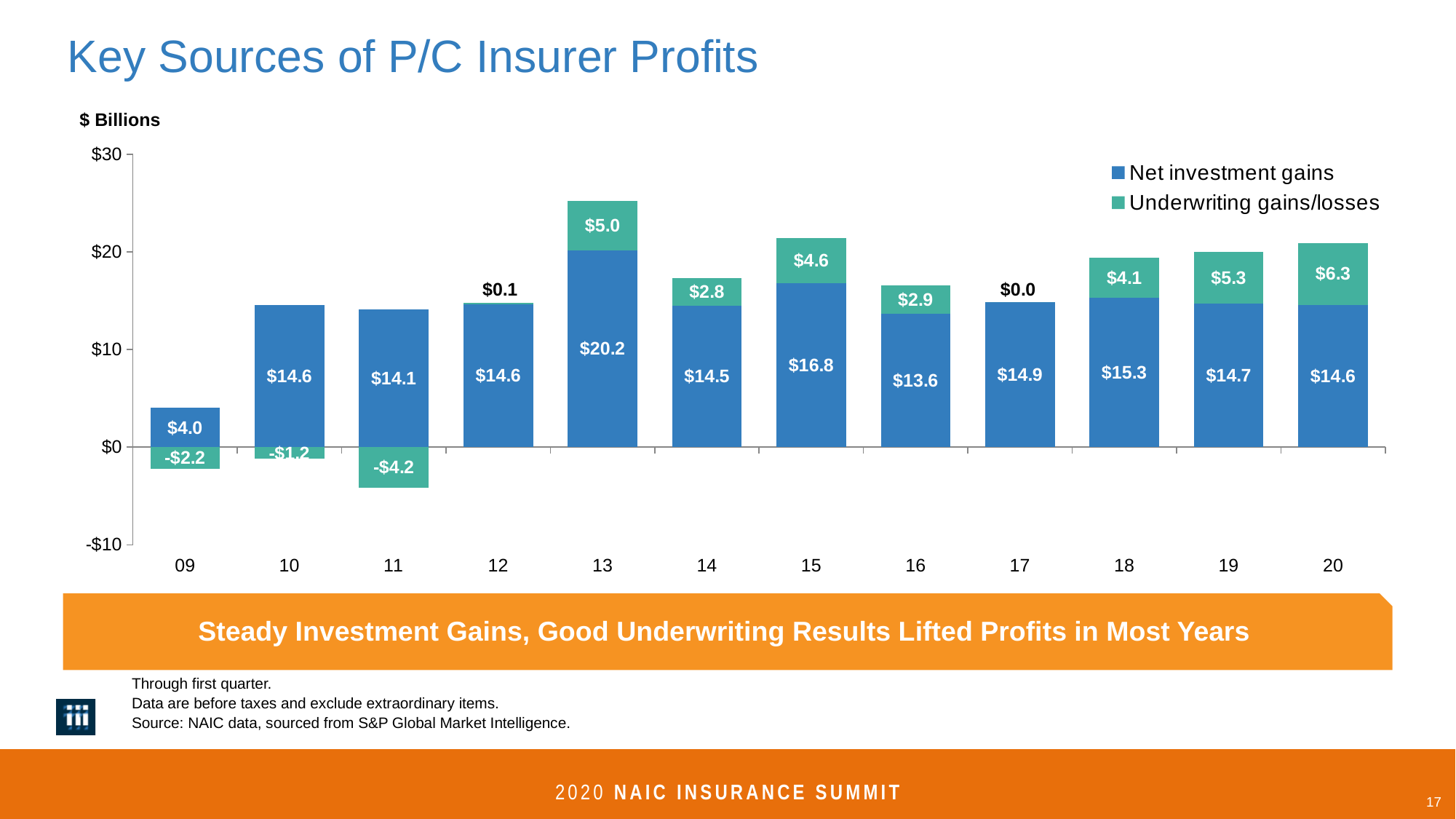
Which year has the lowest Underwriting gains/losses? 11 How many years are shown on the x axis? 12 Which year has larger Underwriting gains/losses, 18 or 19? 19 What is the value of Underwriting gains/losses for 11? -$4.2 Which year has the lowest Net investment gains? 09 How many series does the legend list? 2 What is the value of Net investment gains for 13? $20.2 What is the total of the stacked bar for 13 (Net investment gains plus Underwriting gains/losses)? $25.2 What kind of chart is shown on the slide? Stacked bar chart What is the difference between Net investment gains in 13 and in 09? $16.2 Which year has the highest Net investment gains? 13 Which year has the highest Underwriting gains/losses? 20